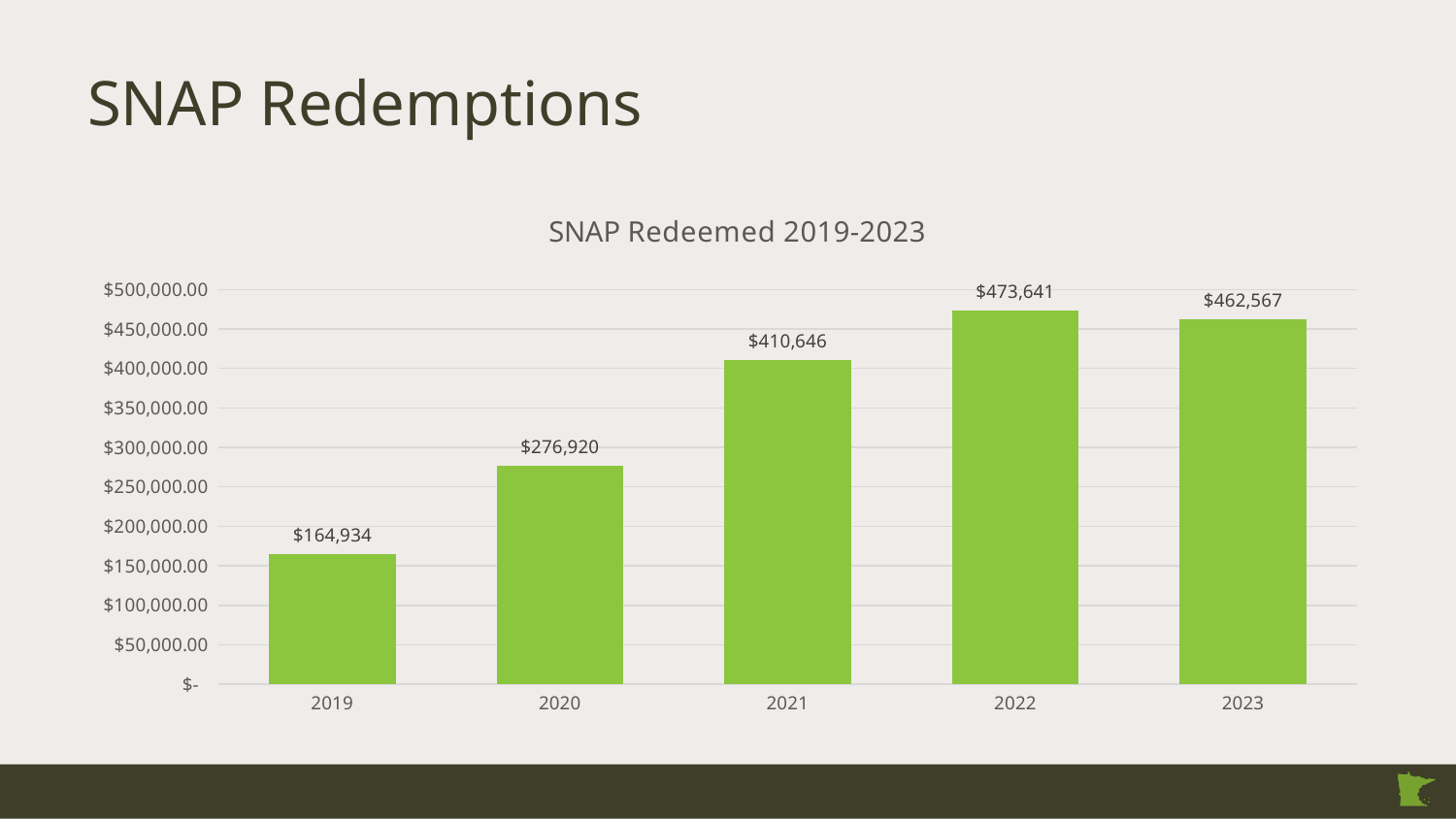
What was the SNAP redeemed value in 2023? $462,567 Is the SNAP redeemed value for 2020 greater or less than $300,000.00? less How many years are shown on the chart? 5 What is the title of the chart? SNAP Redeemed 2019-2023 What kind of chart is shown on the slide? bar chart Which year had a larger SNAP redeemed value, 2020 or 2021? 2021 Which year had the lowest SNAP redeemed value? 2019 What was the SNAP redeemed value in 2021? $410,646 Which year had the highest SNAP redeemed value? 2022 What is the difference between the SNAP redeemed values for 2022 and 2023? $11,074 What was the SNAP redeemed value in 2019? $164,934 What is the difference between the SNAP redeemed values for 2020 and 2019? $111,986